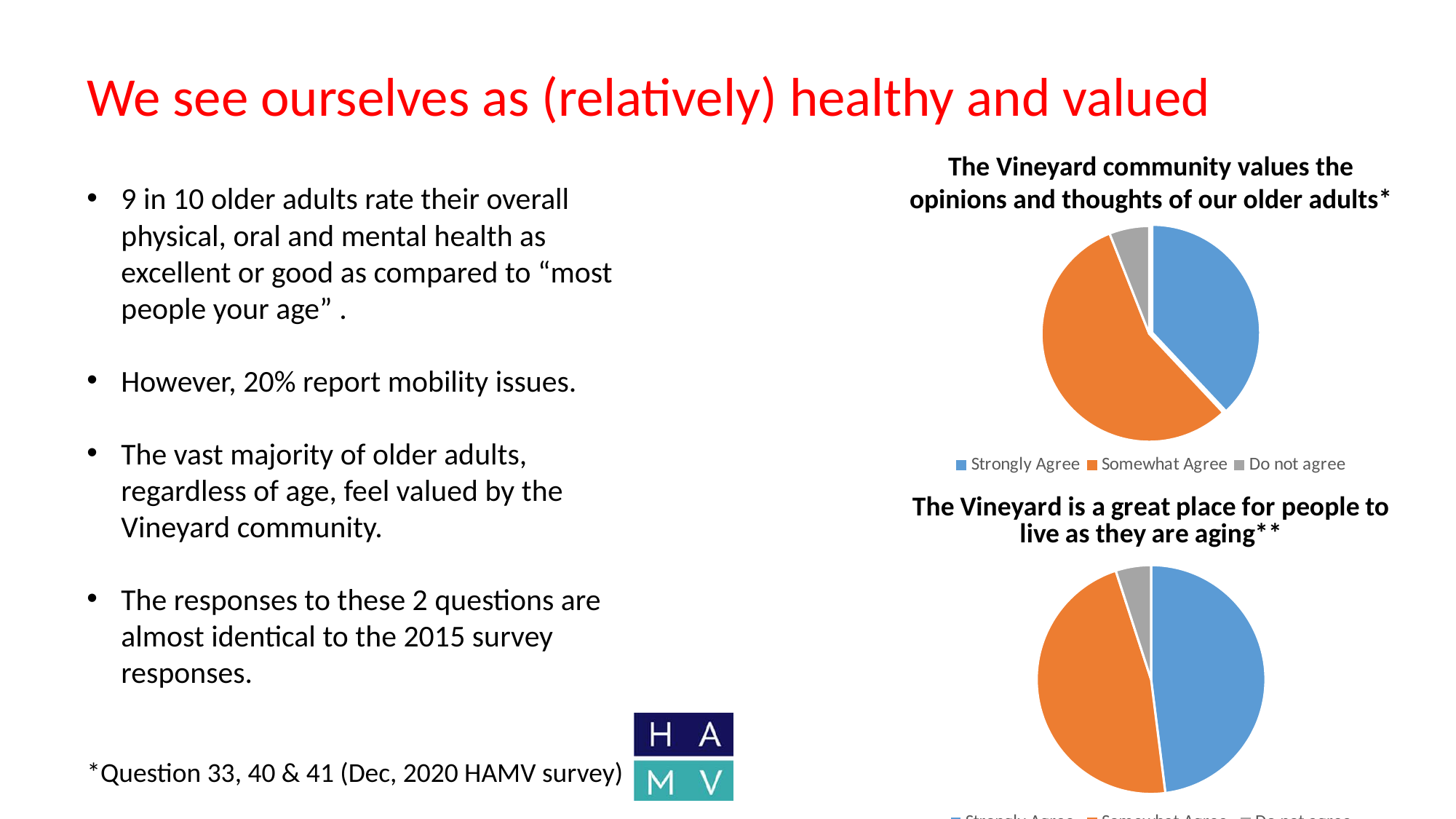
In the bottom pie chart, 'The Vineyard is a great place for people to live as they are aging**', how many slices are there? 3 In the top pie chart, 'The Vineyard community values the opinions and thoughts of our older adults*', which slice is larger: Strongly Agree or Somewhat Agree? Somewhat Agree In the top pie chart, 'The Vineyard community values the opinions and thoughts of our older adults*', which response has the largest slice? Somewhat Agree What is the title of the upper pie chart on the slide? The Vineyard community values the opinions and thoughts of our older adults* How many entries does the legend of the top pie chart, 'The Vineyard community values the opinions and thoughts of our older adults*', list? 3 What kind of chart is 'The Vineyard is a great place for people to live as they are aging**'? Pie chart In the top pie chart, 'The Vineyard community values the opinions and thoughts of our older adults*', which response has the smallest slice? Do not agree In the bottom pie chart, 'The Vineyard is a great place for people to live as they are aging**', which response has the smallest slice? Do not agree What kind of chart is 'The Vineyard community values the opinions and thoughts of our older adults*'? Pie chart In the top pie chart, 'The Vineyard community values the opinions and thoughts of our older adults*', how many slices are there? 3 In the bottom pie chart, 'The Vineyard is a great place for people to live as they are aging**', which slice is larger: Strongly Agree or Do not agree? Strongly Agree In the top pie chart, what colour represents 'Somewhat Agree'? Orange